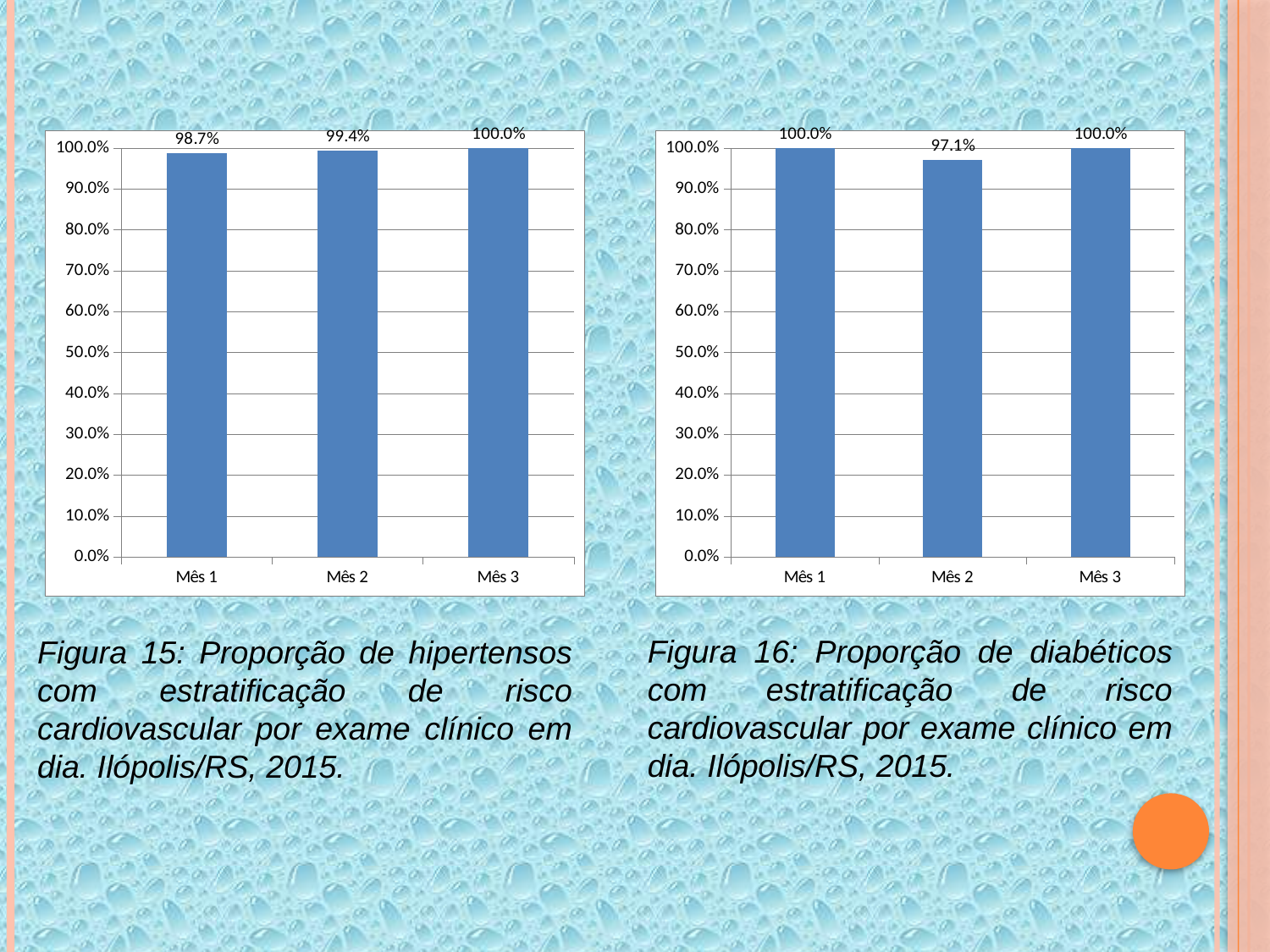
In the left chart (Figura 15), do the values rise or fall from Mês 1 to Mês 3? Rise In the right chart (Figura 16), what is the difference between the values for Mês 1 and Mês 2? 2.9% What kind of chart is the left chart (Figura 15)? Bar chart In the left chart (Figura 15), what is the value for Mês 2? 99.4% In the left chart (Figura 15), what is the value for Mês 1? 98.7% In the right chart (Figura 16), what is the value for Mês 3? 100.0% In the left chart (Figura 15), which is larger, the value for Mês 1 or Mês 2? Mês 2 In the left chart (Figura 15), what is the difference between the values for Mês 3 and Mês 1? 1.3% In the left chart (Figura 15), which month has the lowest value? Mês 1 In the right chart (Figura 16), which month has the lowest value? Mês 2 In the right chart (Figura 16), what is the value for Mês 2? 97.1% How many months are shown in the right chart (Figura 16)? 3